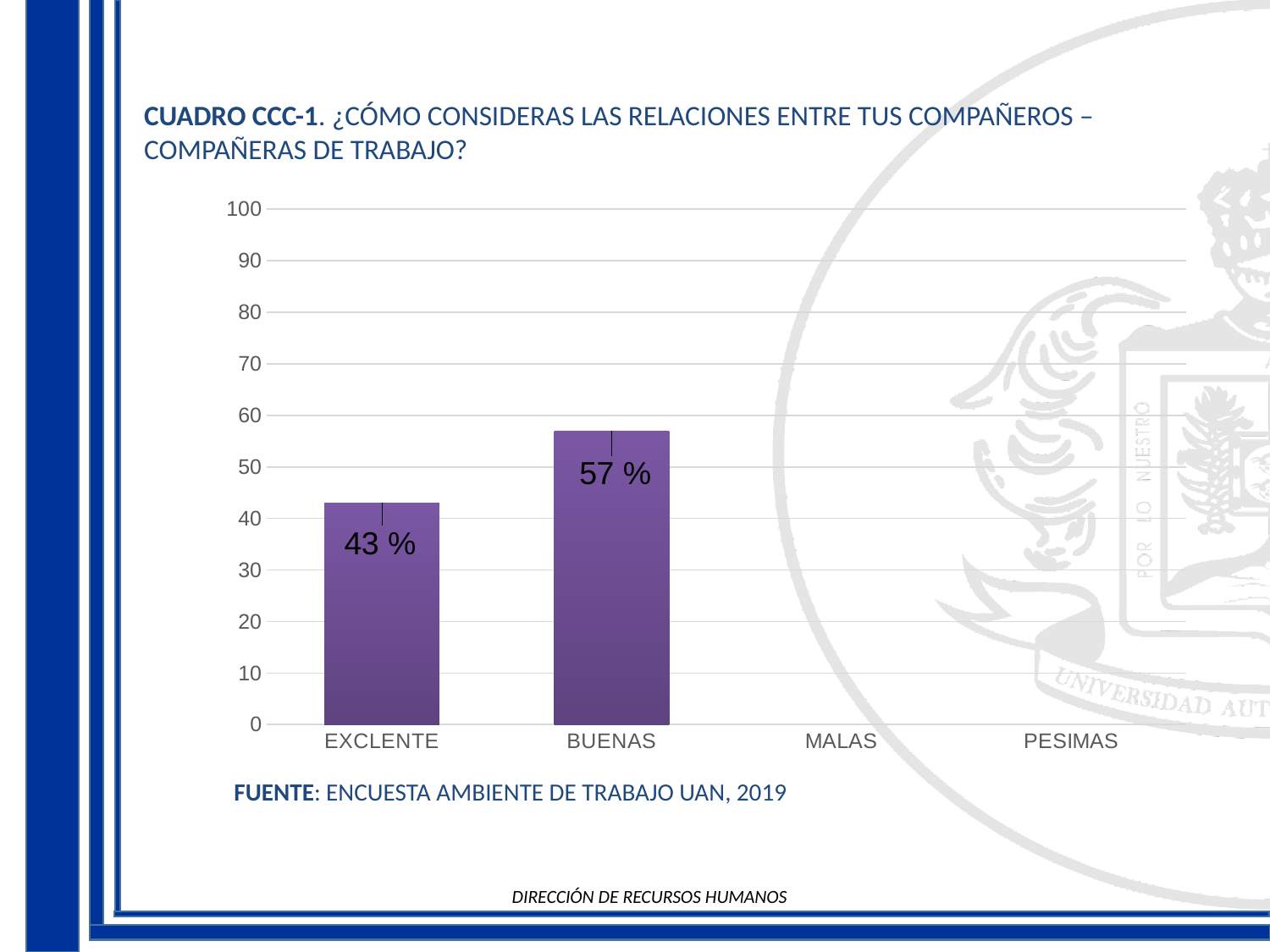
What is the difference between the values for BUENAS and EXCLENTE? 14 % What is the value for EXCLENTE? 43 % What is the highest value shown on the y axis? 100 Is the value for BUENAS greater or less than 50? greater How many categories are shown on the x axis? 4 Is the value for EXCLENTE greater or less than 50? less What is the total of the values for EXCLENTE and BUENAS? 100 % What is the value for BUENAS? 57 % What is the source cited below the chart? ENCUESTA AMBIENTE DE TRABAJO UAN, 2019 What kind of chart is shown on the slide? bar chart Which is larger, the value for EXCLENTE or the value for BUENAS? BUENAS Which category has the highest value? BUENAS